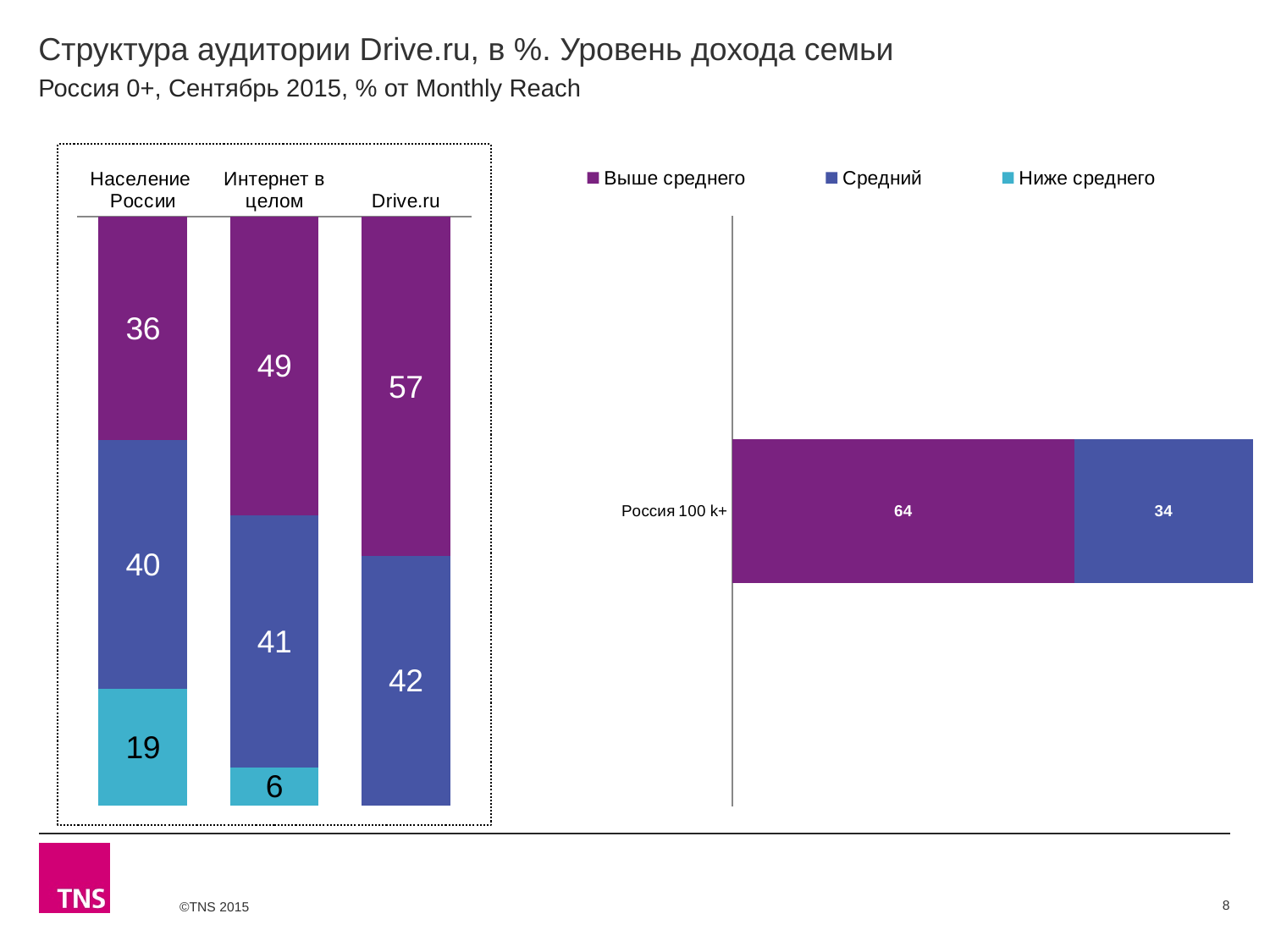
In the left chart, which is larger: the 'Средний' value for Drive.ru or for Население России? Drive.ru In the left chart, what is the 'Средний' value for Интернет в целом? 41 In the left chart, which category has the lowest 'Ниже среднего' value? Интернет в целом In the left chart, what is the 'Ниже среднего' value for Население России? 19 How many series does the legend list? 3 In the left chart, which category has the highest 'Выше среднего' value? Drive.ru In the left chart, what is the difference between the 'Выше среднего' values for Drive.ru and Население России? 21 In the left chart, what is the 'Выше среднего' value for Drive.ru? 57 How many categories are shown in the left chart? 3 What kind of chart is the right chart (Россия 100 k+)? Stacked bar chart In the right chart, what is the 'Выше среднего' value for Россия 100 k+? 64 In the right chart, what is the total of the Россия 100 k+ bar? 98